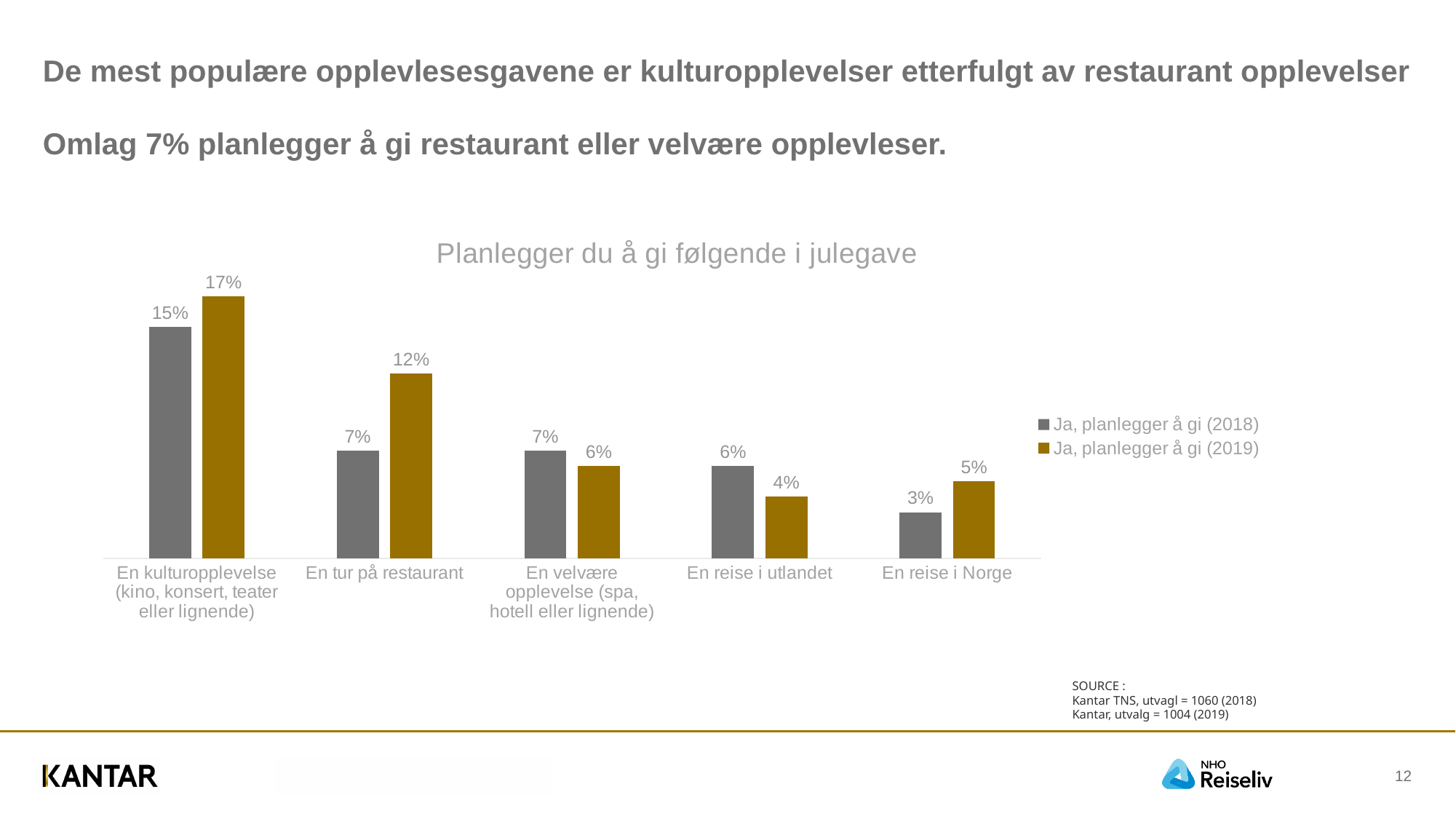
Which category has the highest value in the 'Ja, planlegger å gi (2019)' series? En kulturopplevelse (kino, konsert, teater eller lignende) For 'En velvære opplevelse (spa, hotell eller lignende)', which series has the larger value, 2018 or 2019? Ja, planlegger å gi (2018) How many series does the legend list? 2 What is the title of the chart? Planlegger du å gi følgende i julegave What is the value for 'En kulturopplevelse (kino, konsert, teater eller lignende)' in the 'Ja, planlegger å gi (2019)' series? 17% What is the difference between the 2019 and 2018 values for 'En tur på restaurant'? 5% What is the value for 'En tur på restaurant' in the 'Ja, planlegger å gi (2018)' series? 7% What is the difference between the 2018 and 2019 values for 'En reise i utlandet'? 2% How many categories are shown on the x axis of the chart? 5 What is the value for 'En reise i Norge' in the 'Ja, planlegger å gi (2018)' series? 3% What kind of chart is shown on the slide? Bar chart Which category has the lowest value in the 'Ja, planlegger å gi (2018)' series? En reise i Norge